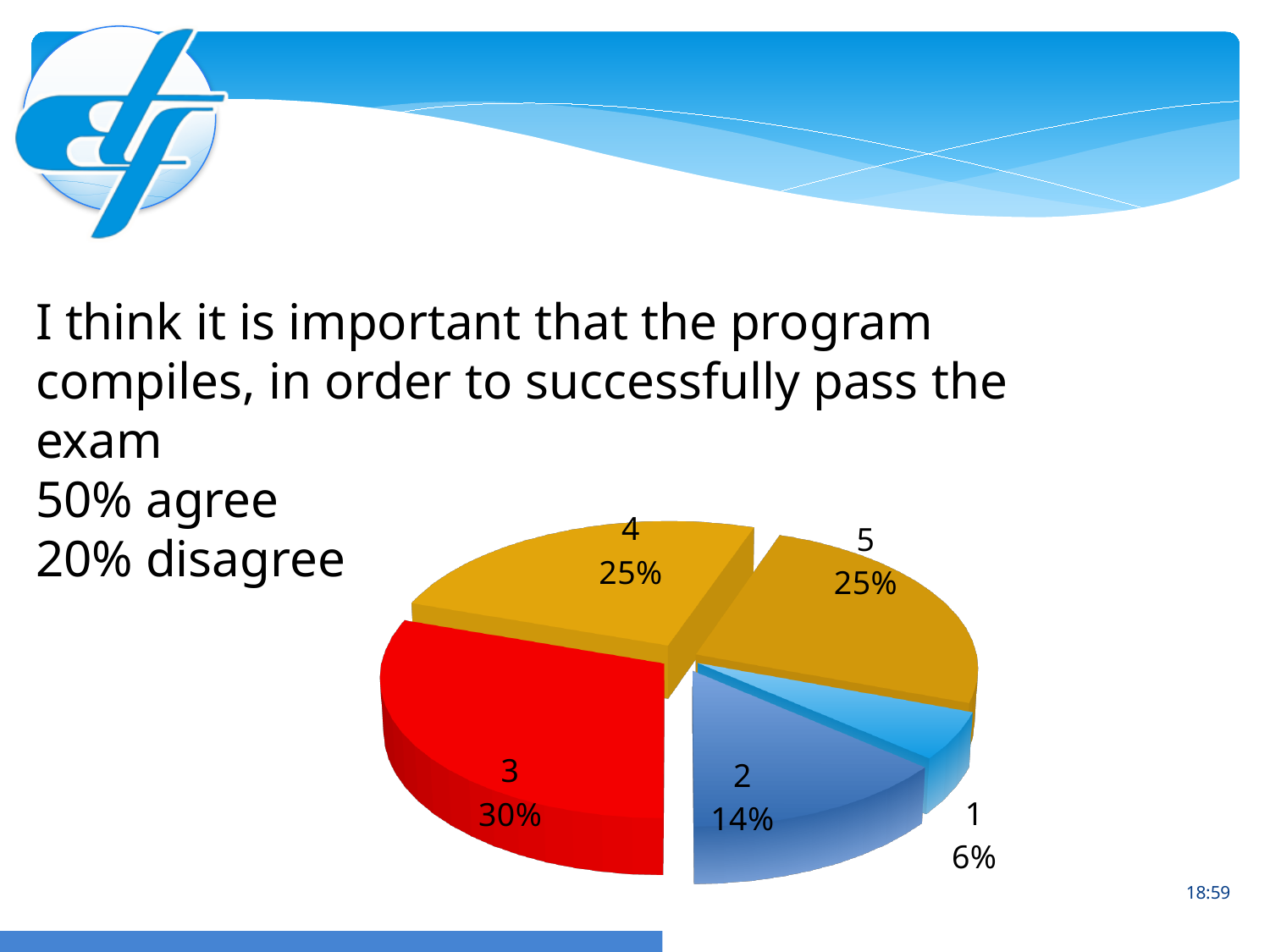
What percentage does slice 1 represent in the pie chart? 6% What percentage does slice 3 represent in the pie chart? 30% Which slice has the smallest share of the pie chart? 1 What colour is slice 3 in the pie chart? red What is the difference in percentage points between slice 2 and slice 1? 8 What is the difference in percentage points between slice 3 and slice 2? 16 What percentage does slice 2 represent in the pie chart? 14% What kind of chart is shown on the slide? pie chart What percentage does slice 4 represent in the pie chart? 25% Which slice is larger, slice 2 or slice 4? 4 How many slices does the pie chart have? 5 Which slice has the largest share of the pie chart? 3